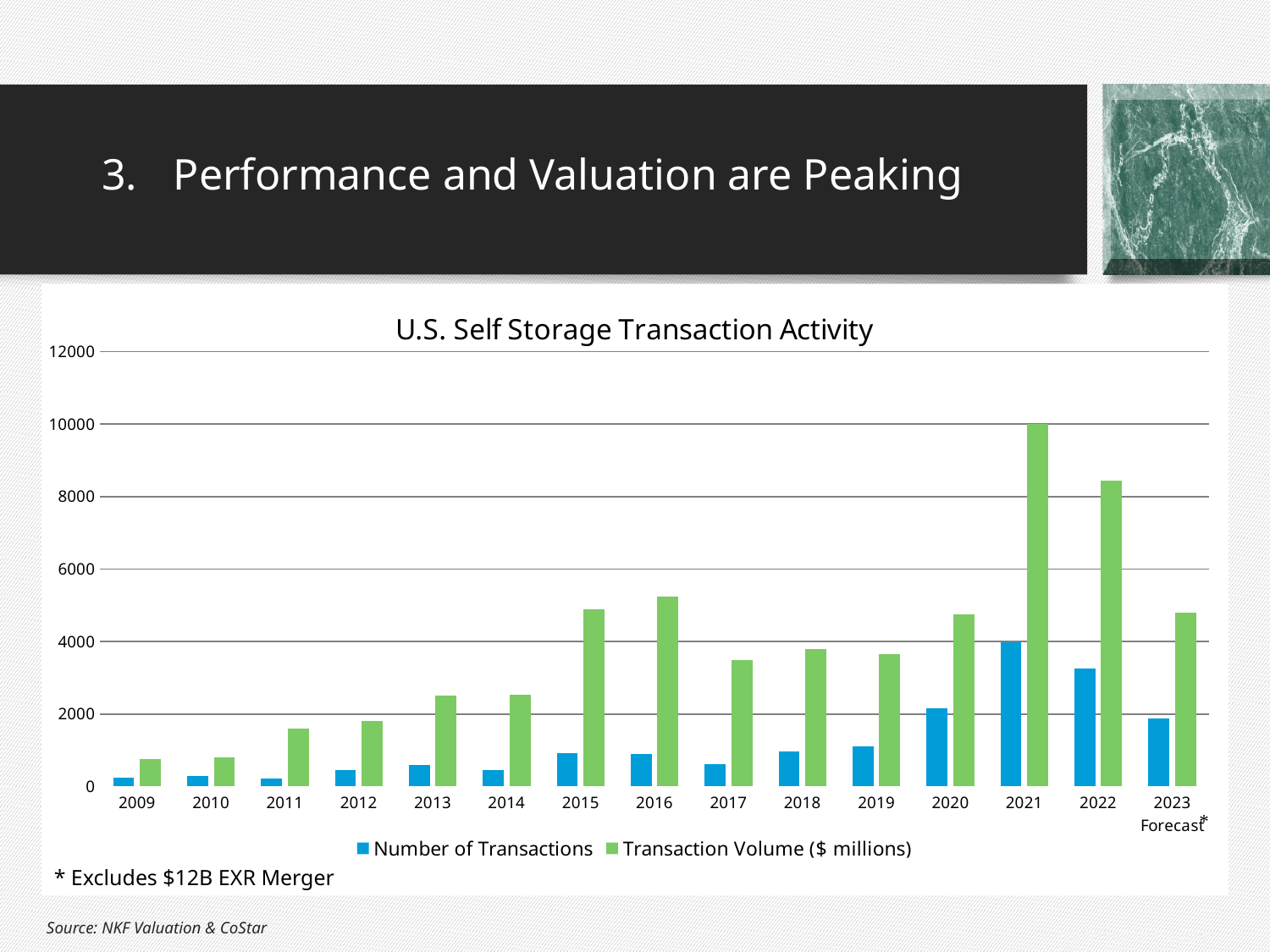
Is the Transaction Volume ($ millions) for 2021 greater or less than 8000? greater Is the Transaction Volume ($ millions) for 2009 greater or less than 2000? less What is the title of the chart? U.S. Self Storage Transaction Activity Which is larger, the Number of Transactions for 2021 or for 2022? 2021 Which year has the highest Transaction Volume ($ millions)? 2021 Which is larger, the Transaction Volume ($ millions) for 2021 or for 2022? 2021 Is the Number of Transactions for 2022 greater or less than 2000? greater How many years (categories) are shown on the x axis? 15 How many series does the legend list? 2 Which year has the highest Number of Transactions? 2021 What kind of chart is shown on the slide? Bar chart Does the Transaction Volume ($ millions) rise or fall from 2009 to 2013? rise